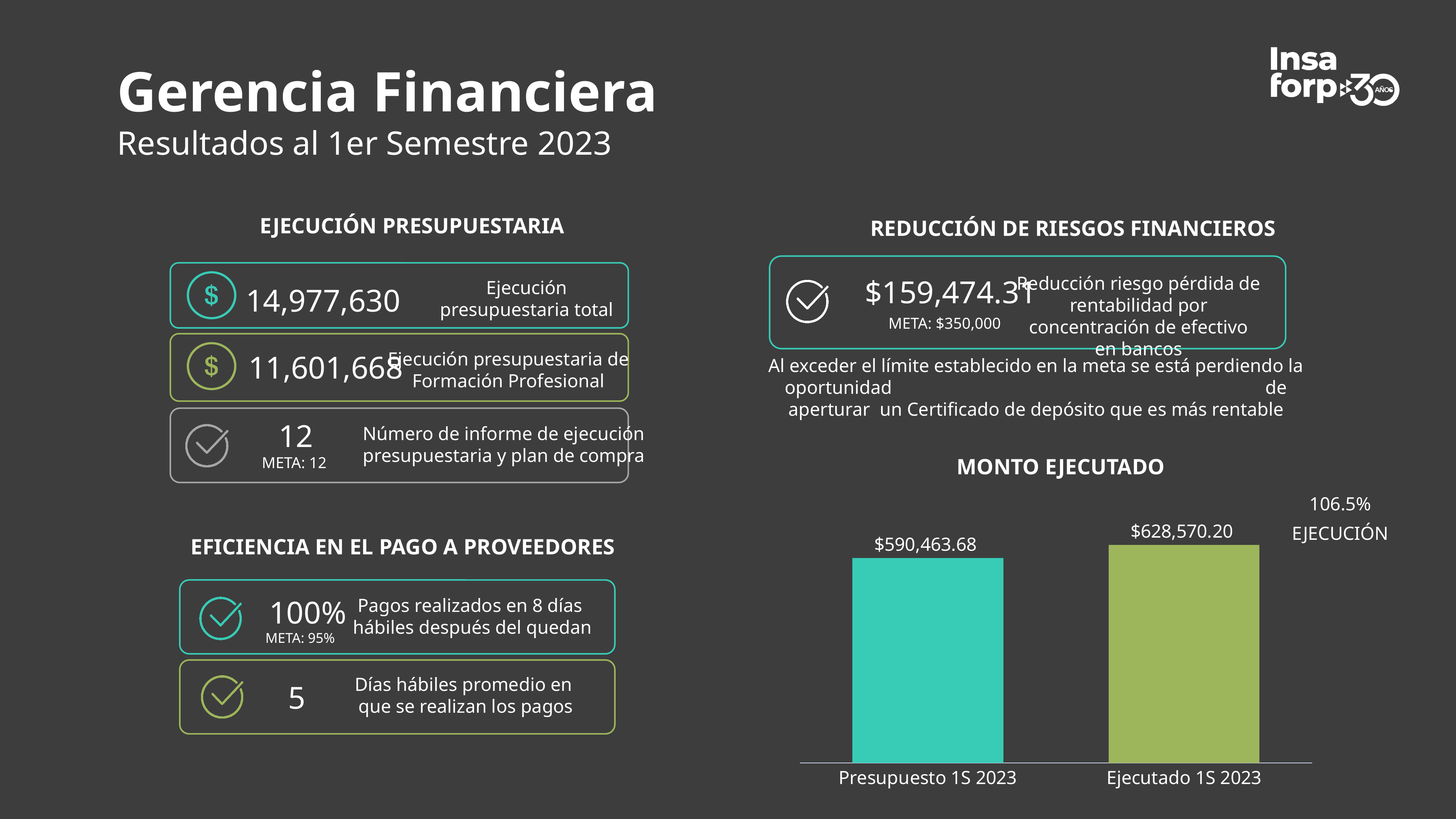
What execution percentage is annotated next to the MONTO EJECUTADO chart? 106.5% In the MONTO EJECUTADO chart, what is the difference between Ejecutado 1S 2023 and Presupuesto 1S 2023? $38,106.52 How many categories are shown in the MONTO EJECUTADO chart? 2 In the MONTO EJECUTADO chart, which category has the lowest value? Presupuesto 1S 2023 In the MONTO EJECUTADO chart, do the values rise or fall from Presupuesto 1S 2023 to Ejecutado 1S 2023? Rise In the MONTO EJECUTADO chart, what is the value for Presupuesto 1S 2023? $590,463.68 What kind of chart is the MONTO EJECUTADO chart? Bar chart In the MONTO EJECUTADO chart, which is larger: Presupuesto 1S 2023 or Ejecutado 1S 2023? Ejecutado 1S 2023 In the MONTO EJECUTADO chart, what is the value for Ejecutado 1S 2023? $628,570.20 What is the title of the bar chart on the slide? MONTO EJECUTADO In the MONTO EJECUTADO chart, which category has the highest value? Ejecutado 1S 2023